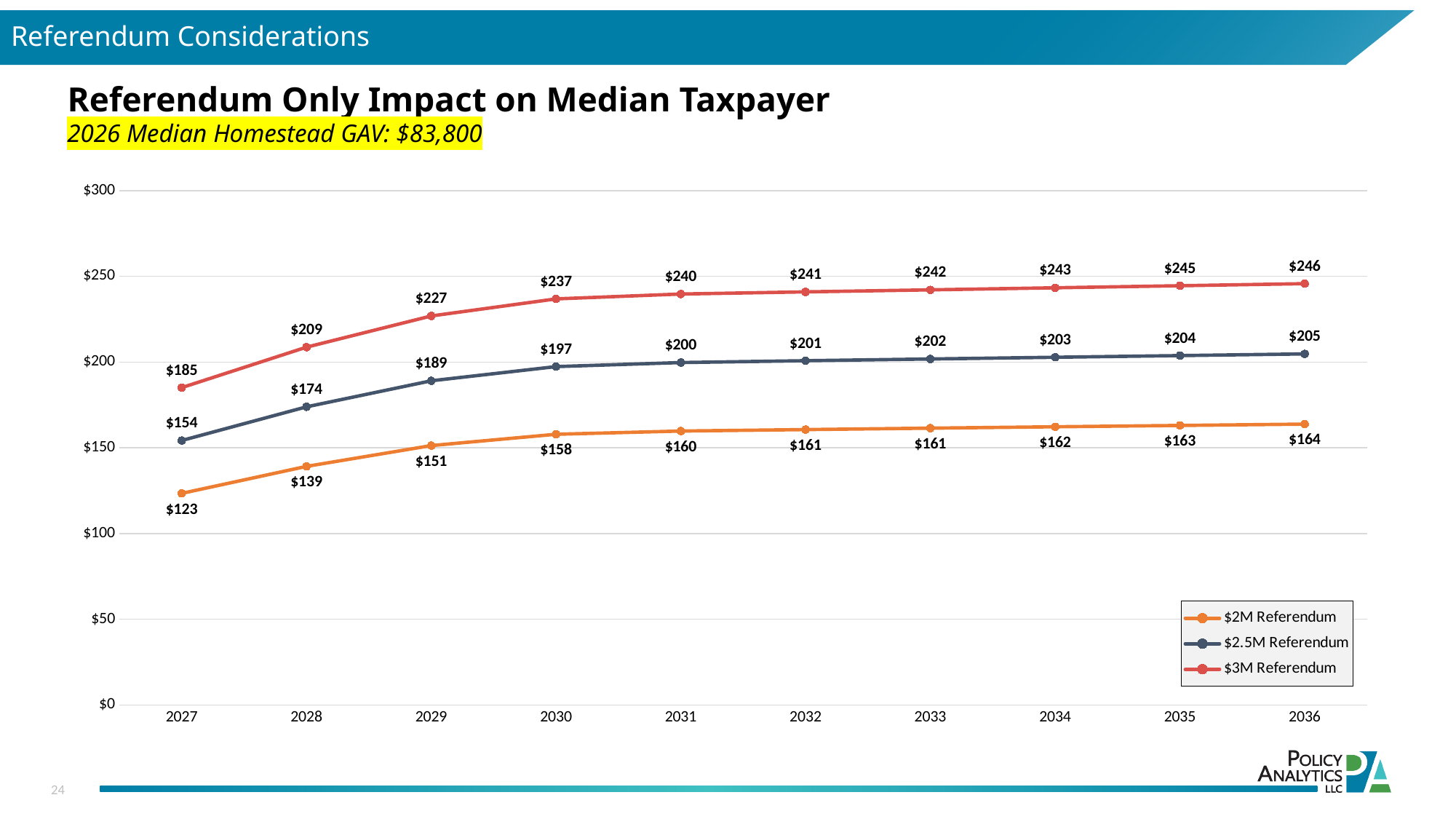
What is the value for the $2M Referendum series in 2027? $123 What is the value for the $2.5M Referendum series in 2036? $205 Which is larger in 2029: the $2.5M Referendum value or the $2M Referendum value? $2.5M Referendum Is the value for the $2M Referendum series in 2028 greater or less than $150? less What is the value for the $3M Referendum series in 2030? $237 In which year is the $2.5M Referendum series at its lowest? 2027 What kind of chart is shown on the slide? line chart In which year is the $3M Referendum series at its highest? 2036 Do the values for the $3M Referendum series rise or fall from 2027 to 2036? rise How many series does the legend list? 3 What is the difference between the $3M Referendum and $2M Referendum values in 2036? $82 How many years are shown on the x axis? 10